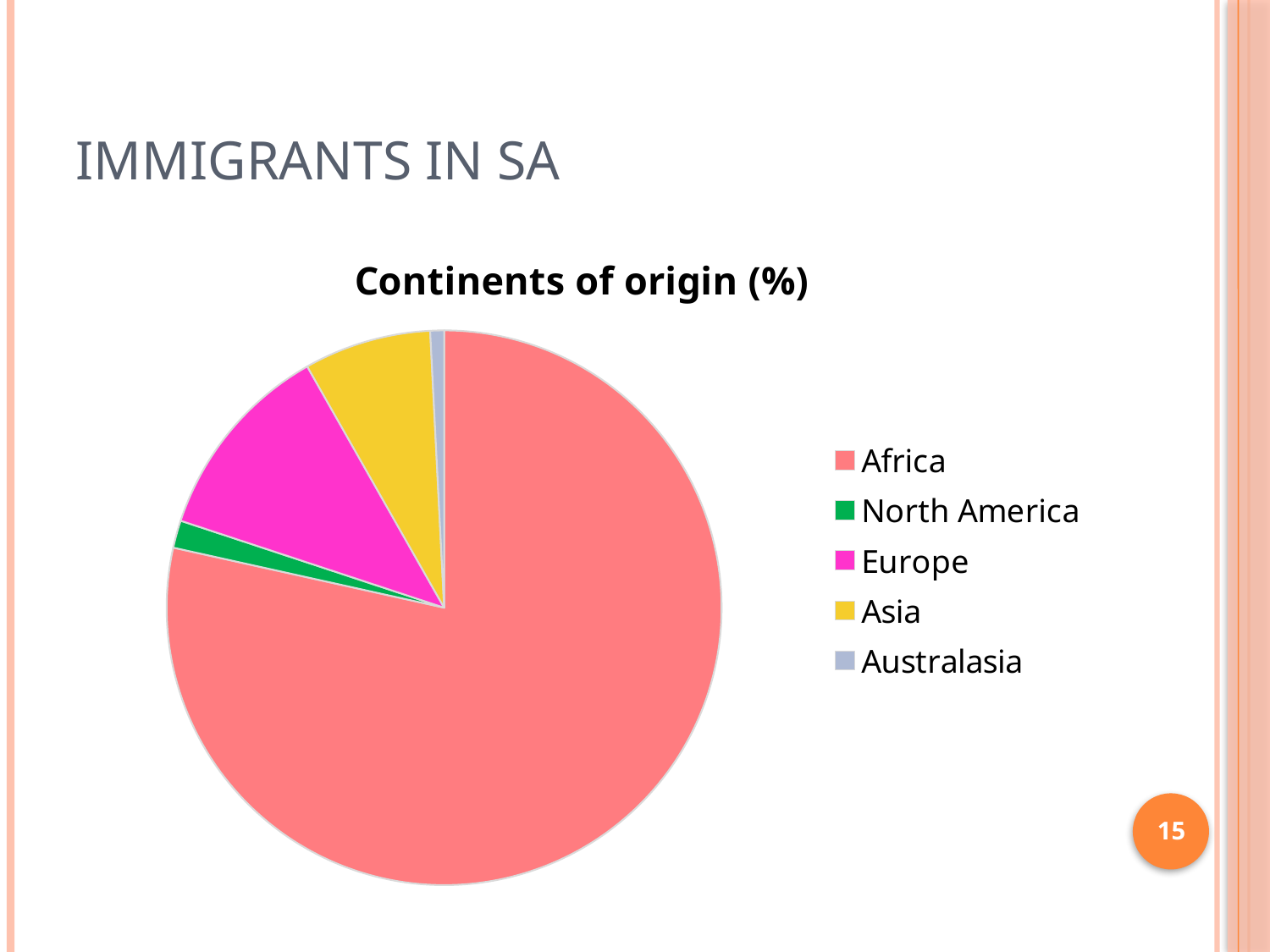
Which continent is represented by the yellow slice? Asia Which slice is larger, Europe or Asia? Europe Which slice is larger, Africa or Europe? Africa Which slice is larger, North America or Australasia? North America Which continent has the smallest slice of the pie chart? Australasia What type of chart is shown on the slide? pie chart What is the title of the chart? Continents of origin (%) Which continent has the largest slice of the pie chart? Africa How many categories does the legend of the pie chart list? 5 How many slices does the pie chart have? 5